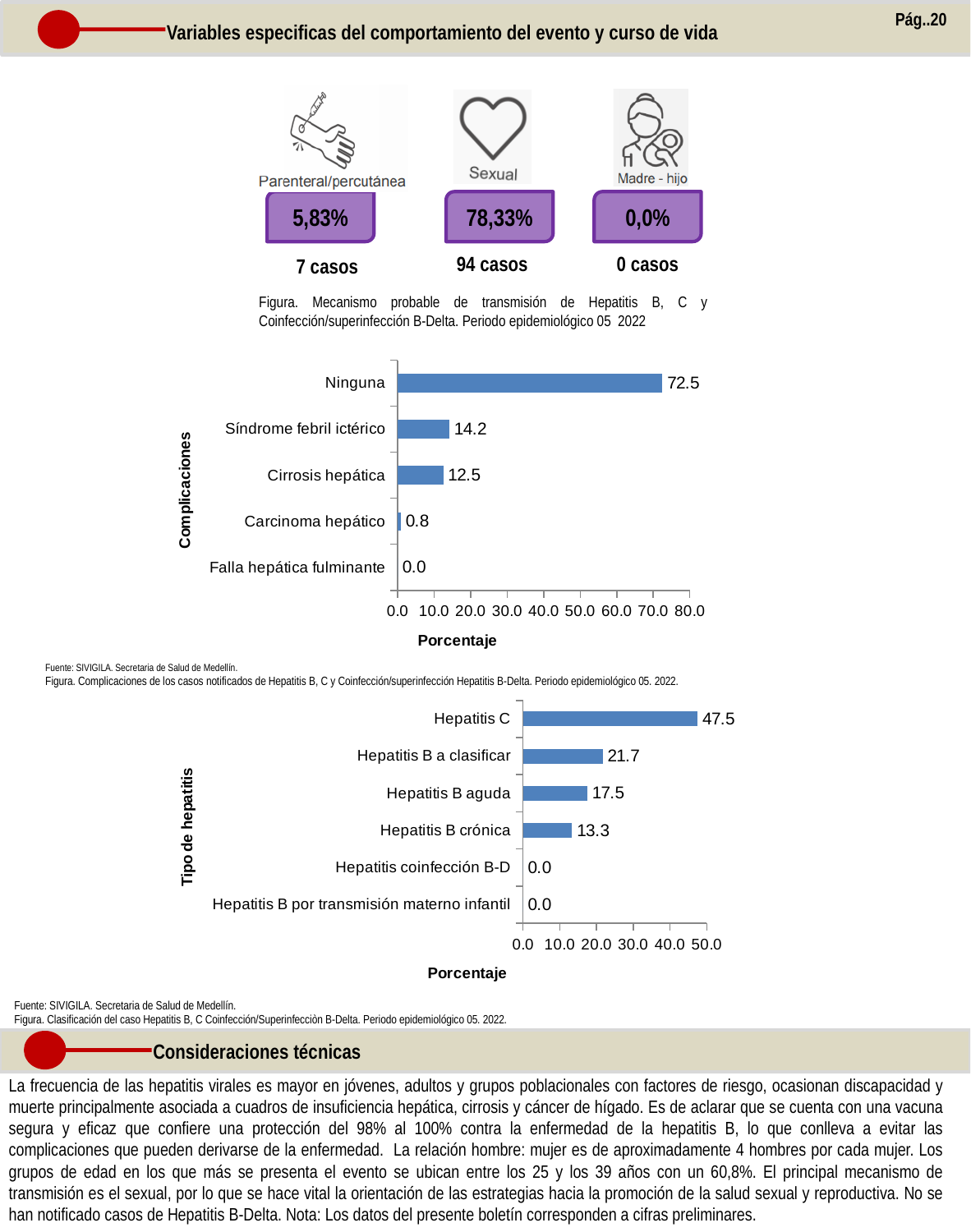
In the lower bar chart (Tipo de hepatitis), which category has the highest value? Hepatitis C In the upper bar chart (Complicaciones), what is the value for Ninguna? 72.5 In the upper bar chart (Complicaciones), what is the value for Cirrosis hepática? 12.5 In the lower bar chart (Tipo de hepatitis), which is larger: Hepatitis B a clasificar or Hepatitis B aguda? Hepatitis B a clasificar In the lower bar chart (Tipo de hepatitis), what is the value for Hepatitis C? 47.5 In the upper bar chart (Complicaciones), which category has the lowest value? Falla hepática fulminante In the lower bar chart (Tipo de hepatitis), what is the difference between Hepatitis C and Hepatitis B a clasificar? 25.8 In the upper bar chart (Complicaciones), how many categories are shown? 5 In the upper bar chart (Complicaciones), what is the difference between Síndrome febril ictérico and Cirrosis hepática? 1.7 In the upper bar chart (Complicaciones), what is the label of the x axis? Porcentaje In the lower bar chart (Tipo de hepatitis), what is the value for Hepatitis B crónica? 13.3 What kind of chart is the lower chart (Tipo de hepatitis)? Bar chart